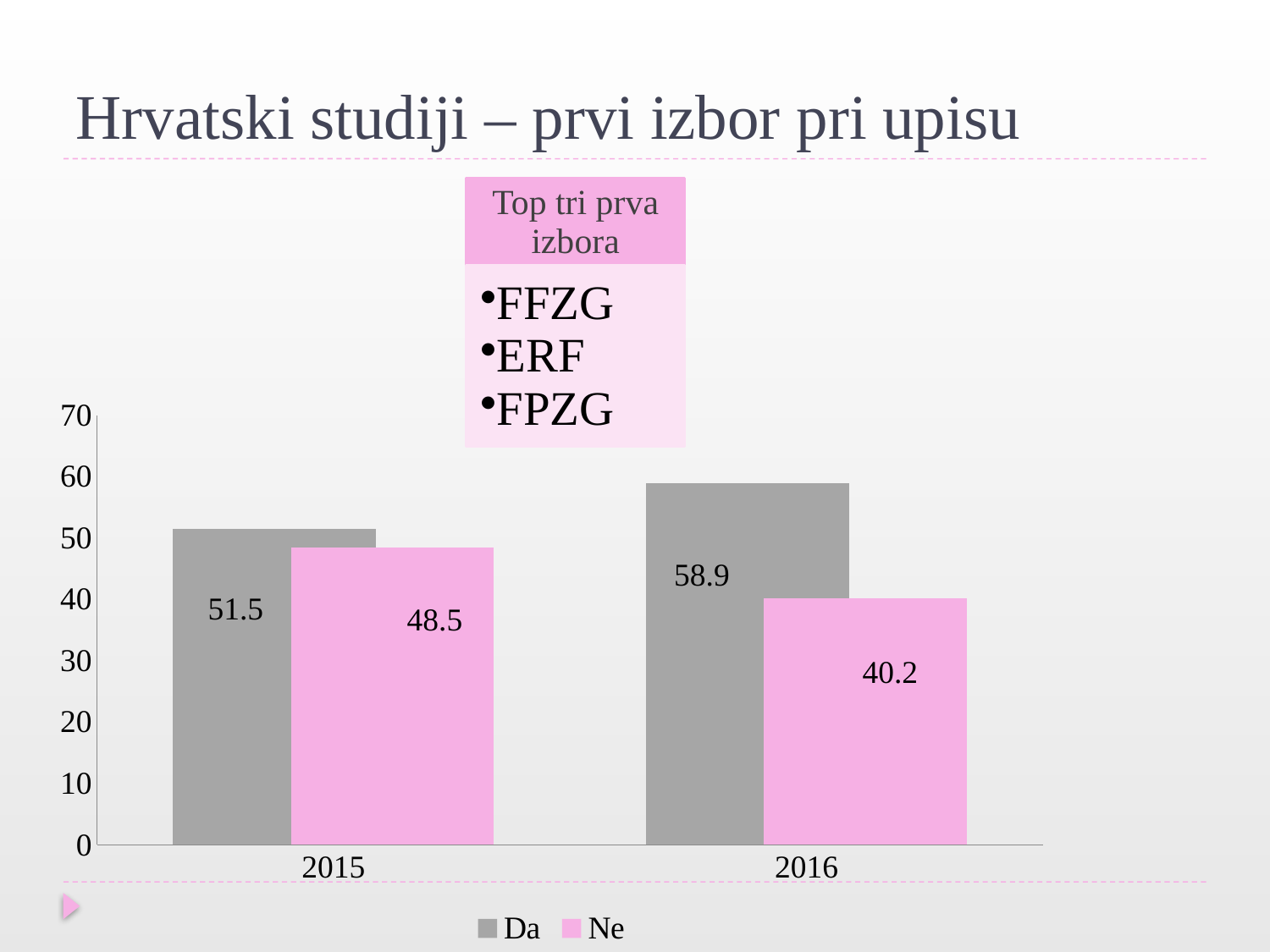
How many series does the legend list? 2 What is the value for Ne in 2016? 40.2 Is the value for Da in 2016 greater or less than 50? greater In which year is the Ne value lowest? 2016 How many years are shown on the x axis? 2 What is the value for Da in 2016? 58.9 What kind of chart is shown on the slide? bar chart In which year is the Da value highest? 2016 What is the value for Da in 2015? 51.5 What is the difference between the Da and Ne values in 2016? 18.7 What is the value for Ne in 2015? 48.5 Which is larger in 2015, Da or Ne? Da